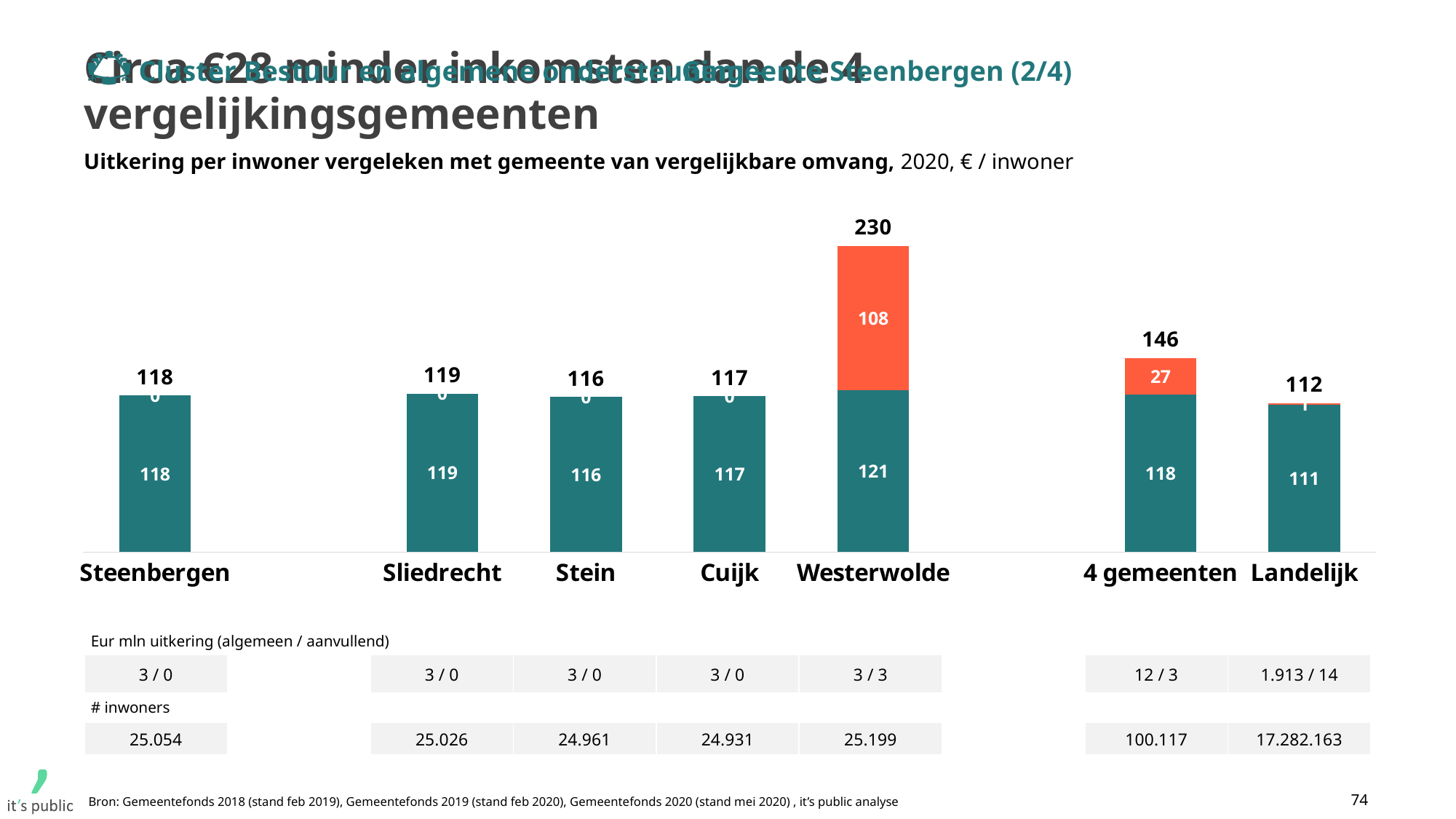
What is the total value shown above the bar for Landelijk? 112 What is the value of the teal (bottom) segment for Westerwolde? 121 What kind of chart is shown on the slide? Stacked bar chart How many categories are shown on the x axis of the chart? 7 Which category has the highest total value? Westerwolde What is the total of the stacked bar for 4 gemeenten, given segments of 118 and 27? 146 Which category has the lowest total value? Landelijk Which is larger, the total for 4 gemeenten or the total for Sliedrecht? 4 gemeenten What is the value of the orange (top) segment for 4 gemeenten? 27 What is the number of inhabitants (# inwoners) listed for Steenbergen below the chart? 25.054 What is the difference between the total for Westerwolde and the total for Steenbergen? 112 What is the total value shown above the bar for Westerwolde? 230